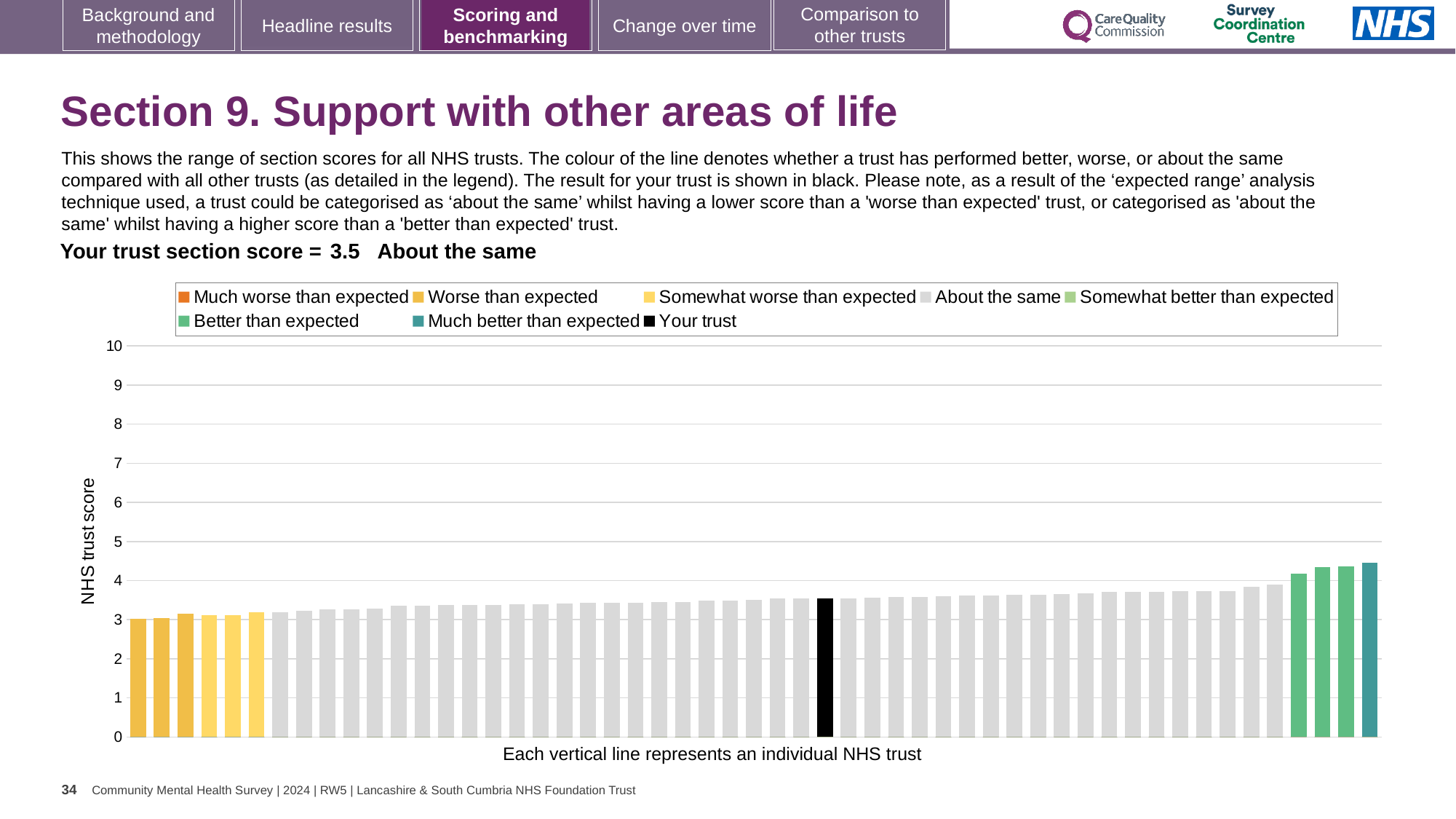
Is the value for your trust greater or less than 3? greater What kind of chart is shown on the slide? bar chart Is the value for your trust greater or less than 4? less How many entries does the chart legend list? 8 Which category is your trust placed in for this section? About the same What colour is the bar representing your trust? black Is the shortest bar in the chart greater or less than 2? greater Do the bar values rise or fall from left to right along the x axis? rise Which legend category does the tallest bar belong to? Much better than expected What is the title of the vertical axis? NHS trust score What is the section score for your trust? 3.5